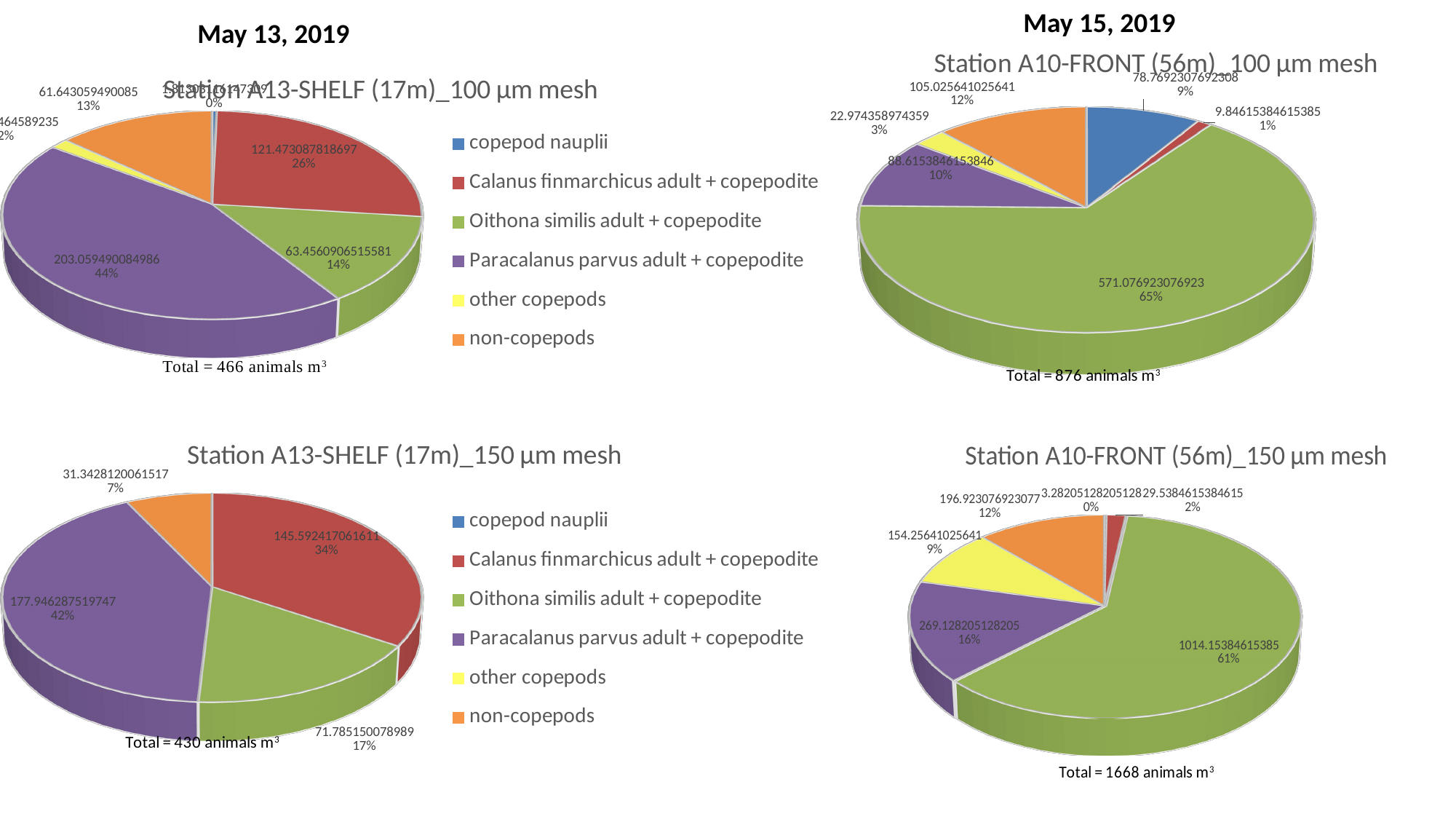
What total is stated below the Station A10-FRONT (56m)_150 µm mesh chart? Total = 1668 animals m³ In the Station A13-SHELF (17m)_150 µm mesh chart, which category has the largest slice? Paracalanus parvus adult + copepodite In the Station A10-FRONT (56m)_100 µm mesh chart, what share of the pie is Oithona similis adult + copepodite? 65% How many categories does the legend next to the Station A13-SHELF (17m)_100 µm mesh chart list? 6 What kind of chart is the Station A13-SHELF (17m)_150 µm mesh chart? pie chart In the Station A13-SHELF (17m)_150 µm mesh chart, what share of the pie is Calanus finmarchicus adult + copepodite? 34% In the Station A13-SHELF (17m)_100 µm mesh chart, which is larger: the Calanus finmarchicus adult + copepodite slice or the Oithona similis adult + copepodite slice? Calanus finmarchicus adult + copepodite In the Station A10-FRONT (56m)_100 µm mesh chart, what is the value labelled for non-copepods? 105.025641025641 In the Station A10-FRONT (56m)_150 µm mesh chart, what is the value labelled for Oithona similis adult + copepodite? 1014.15384615385 In the Station A10-FRONT (56m)_100 µm mesh chart, which category has the smallest slice? Calanus finmarchicus adult + copepodite In the Station A10-FRONT (56m)_150 µm mesh chart, what share of the pie is Paracalanus parvus adult + copepodite? 16%